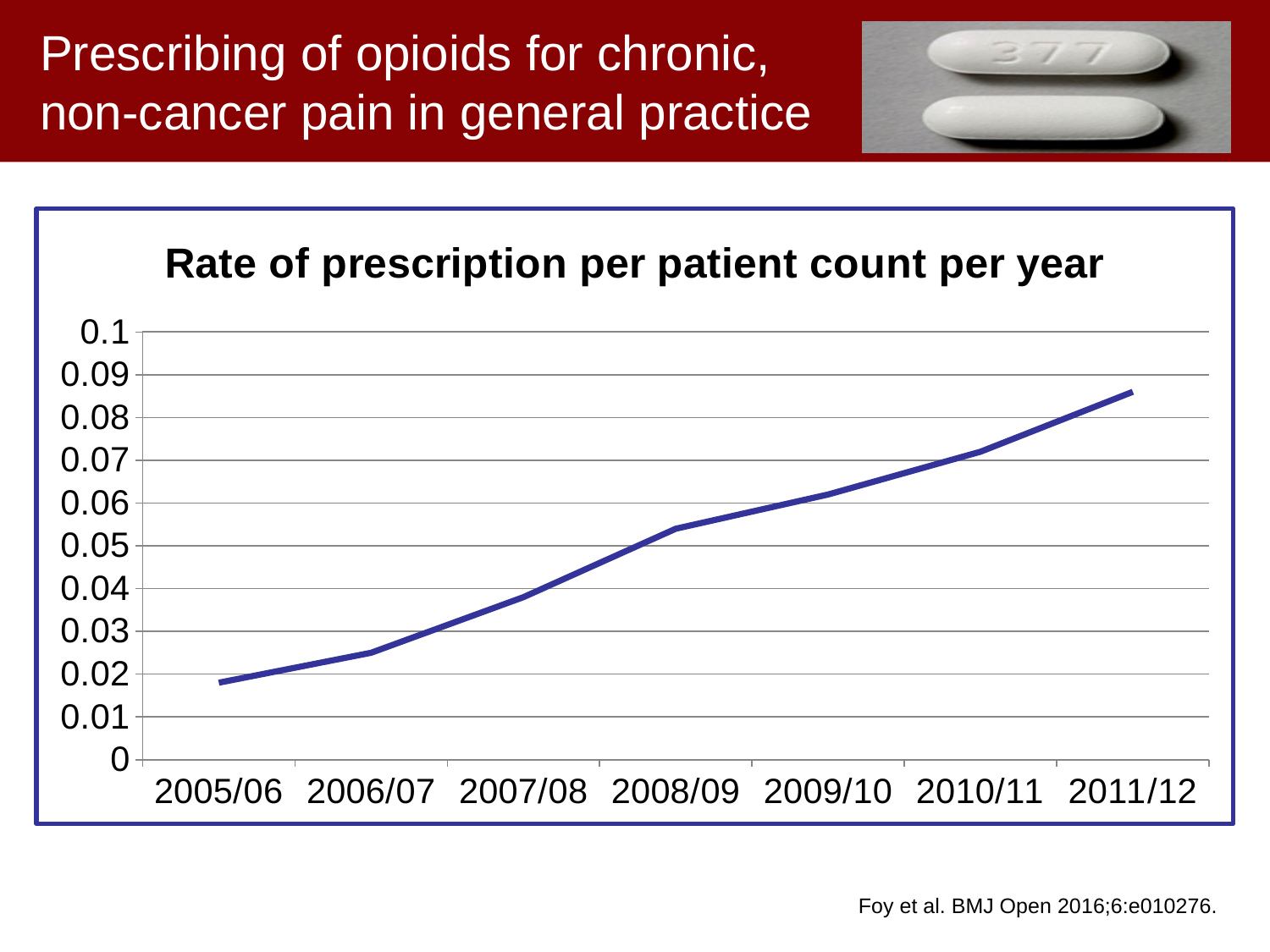
Is the value for 2009/10 greater or less than 0.07? less Which year has the lowest rate of prescription? 2005/06 Do the values rise or fall from 2005/06 to 2011/12? rise Is the value for 2006/07 greater or less than 0.03? less What is the title of the chart? Rate of prescription per patient count per year Which year has the highest rate of prescription? 2011/12 Is the value for 2011/12 greater or less than 0.08? greater What kind of chart is shown on the slide? line chart Which is larger, the value for 2007/08 or the value for 2010/11? 2010/11 How many years are plotted on the x axis of the chart? 7